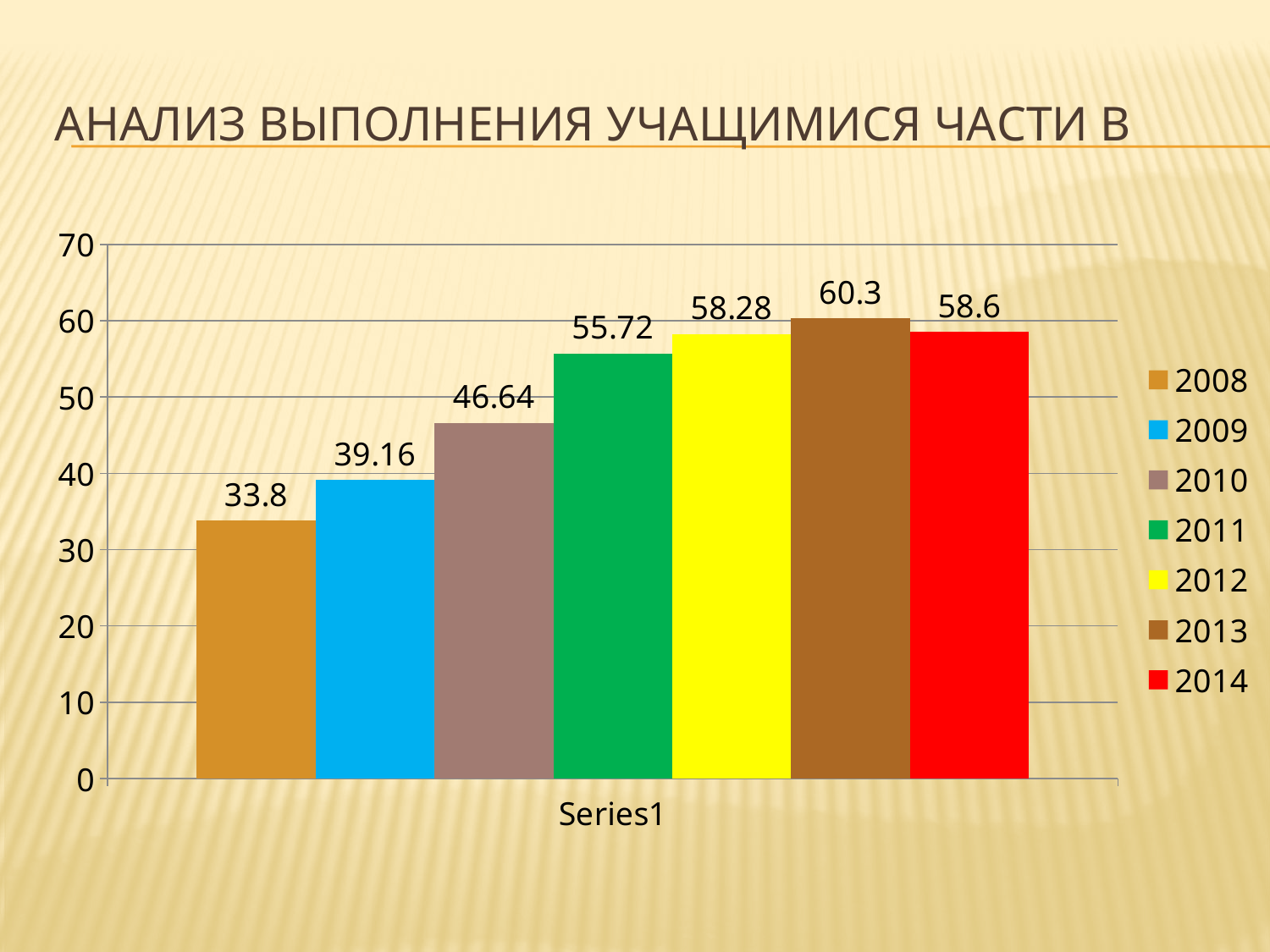
How many series does the legend list? 7 What is the value for 2011? 55.72 What is the difference between the values for 2013 and 2008? 26.5 Which year has the highest value? 2013 What colour is the bar for 2012? yellow Is the value for 2009 greater or less than 40? less What kind of chart is shown on the slide? bar chart Which year has the lowest value? 2008 What is the value for 2014? 58.6 Which is larger, the value for 2012 or the value for 2010? 2012 What is the difference between the values for 2010 and 2009? 7.48 What is the value for 2008? 33.8